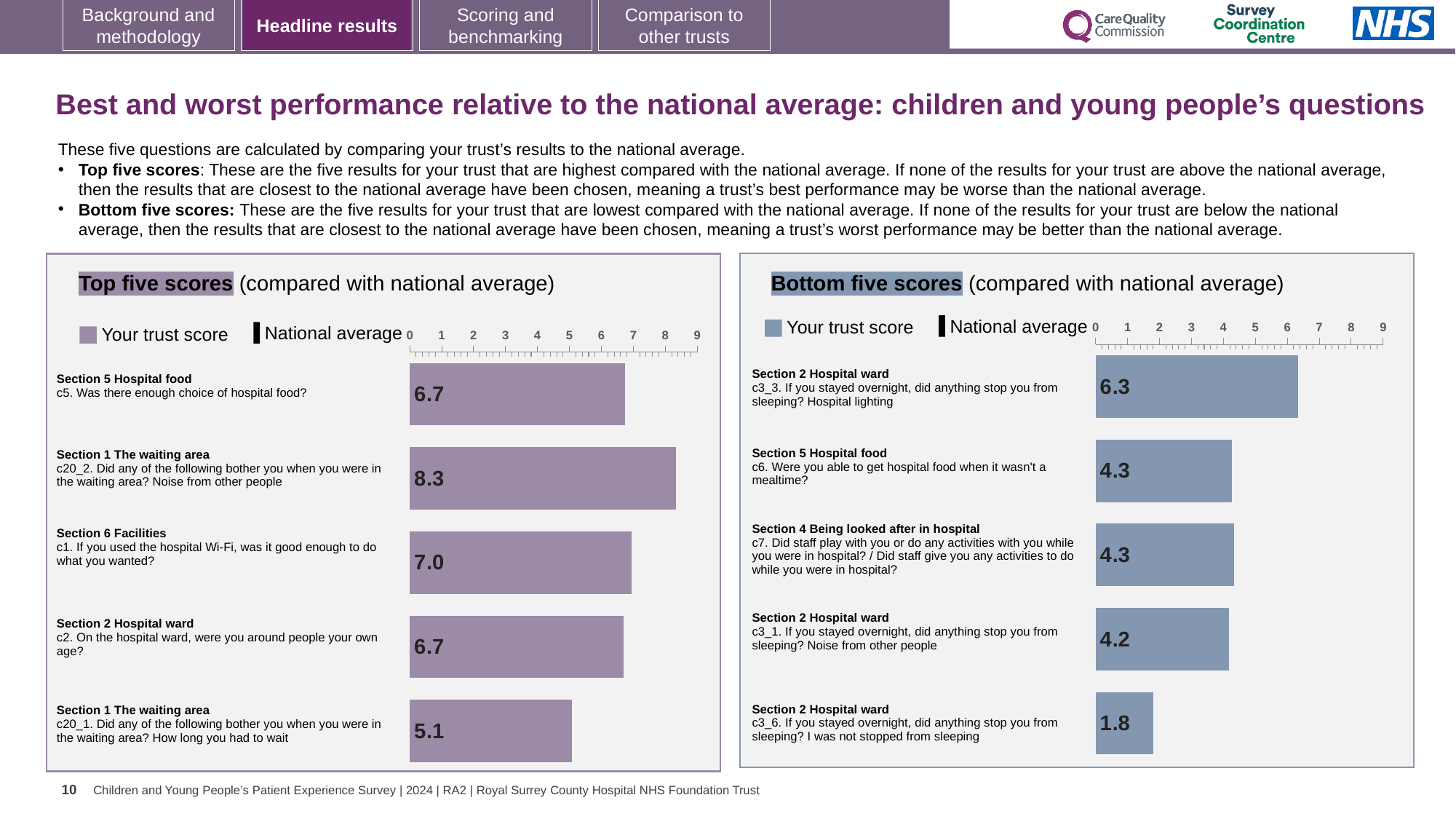
In the Top five scores chart, what is the trust score for c20_2 (noise from other people in the waiting area)? 8.3 How many questions are shown in the Bottom five scores chart? 5 In the Top five scores chart, what is the difference between the trust scores for c20_2 (noise from other people) and c20_1 (how long you had to wait)? 3.2 What type of chart is the Top five scores chart? Bar chart In the Top five scores chart, what is the trust score for c1 (hospital Wi-Fi)? 7.0 In the Top five scores chart, which question has the highest trust score? c20_2. Did any of the following bother you when you were in the waiting area? Noise from other people In the Bottom five scores chart, what is the trust score for c3_3 (hospital lighting)? 6.3 In the Bottom five scores chart, which has the larger trust score: c3_3 (hospital lighting) or c6 (hospital food when it wasn't a mealtime)? c3_3 (hospital lighting) In the Bottom five scores chart, what is the trust score for c3_6 (I was not stopped from sleeping)? 1.8 In the Top five scores chart, which question has the lowest trust score? c20_1. Did any of the following bother you when you were in the waiting area? How long you had to wait In the Bottom five scores chart, what is the difference between the trust scores for c3_3 (hospital lighting) and c3_6 (I was not stopped from sleeping)? 4.5 In the Bottom five scores chart, which question has the lowest trust score? c3_6. If you stayed overnight, did anything stop you from sleeping? I was not stopped from sleeping